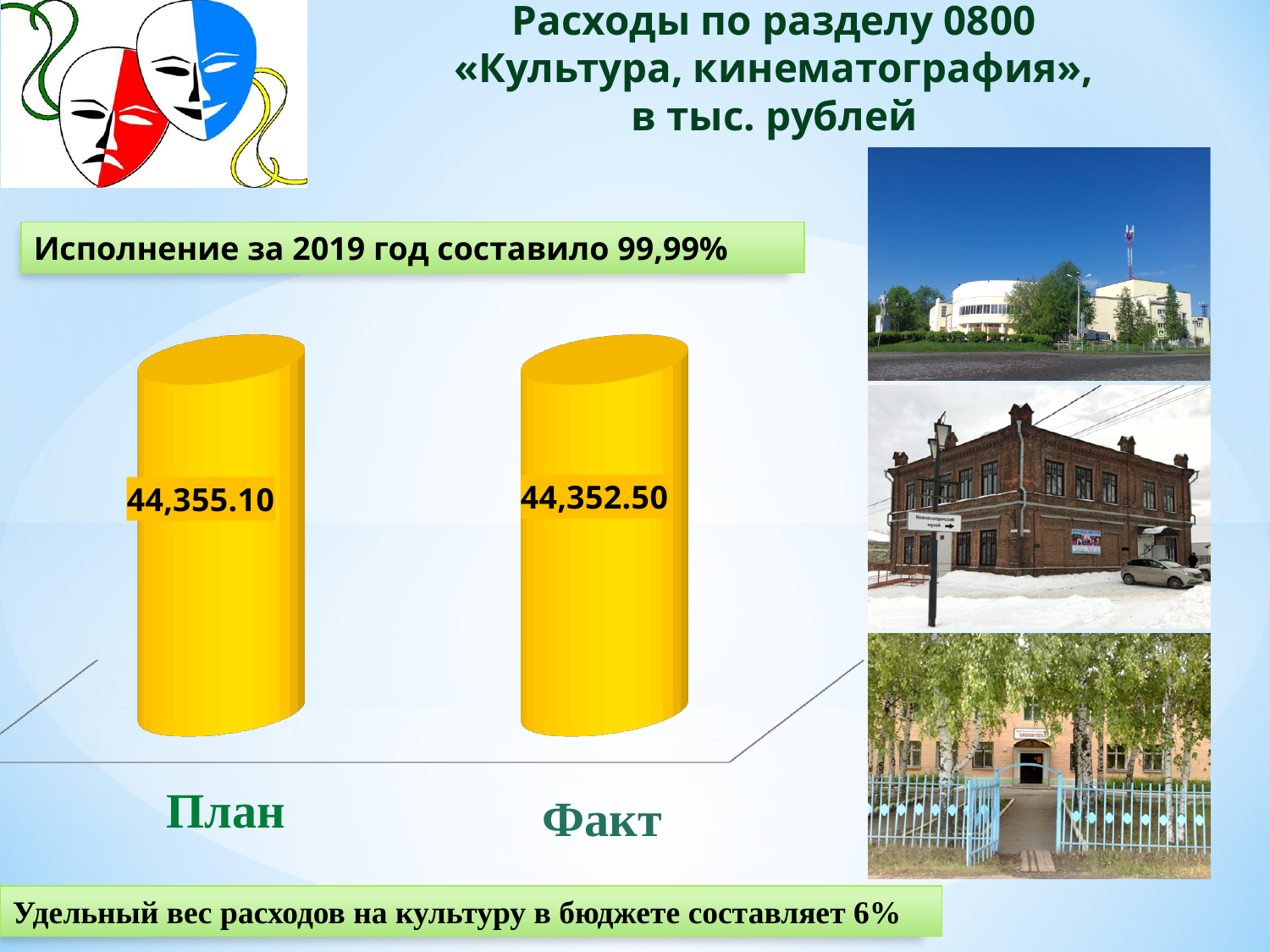
How many categories are shown in the chart? 2 What colour are the bars in the chart? Yellow Which category has the higher value according to the data labels, План or Факт? План What is the value for План (Plan) in the chart? 44,355.10 What is the value for Факт (Fact) in the chart? 44,352.50 Which category has the lowest value according to the data labels? Факт What is the difference between the План and Факт values in the chart? 2.60 According to the slide, what was the execution (Исполнение) for 2019? 99,99% According to the slide, what share of the budget do culture expenditures make up? 6% What are the category labels on the chart's x axis? План, Факт What kind of chart is shown on the slide? Bar chart In what units are the chart values expressed, according to the slide title? тыс. рублей